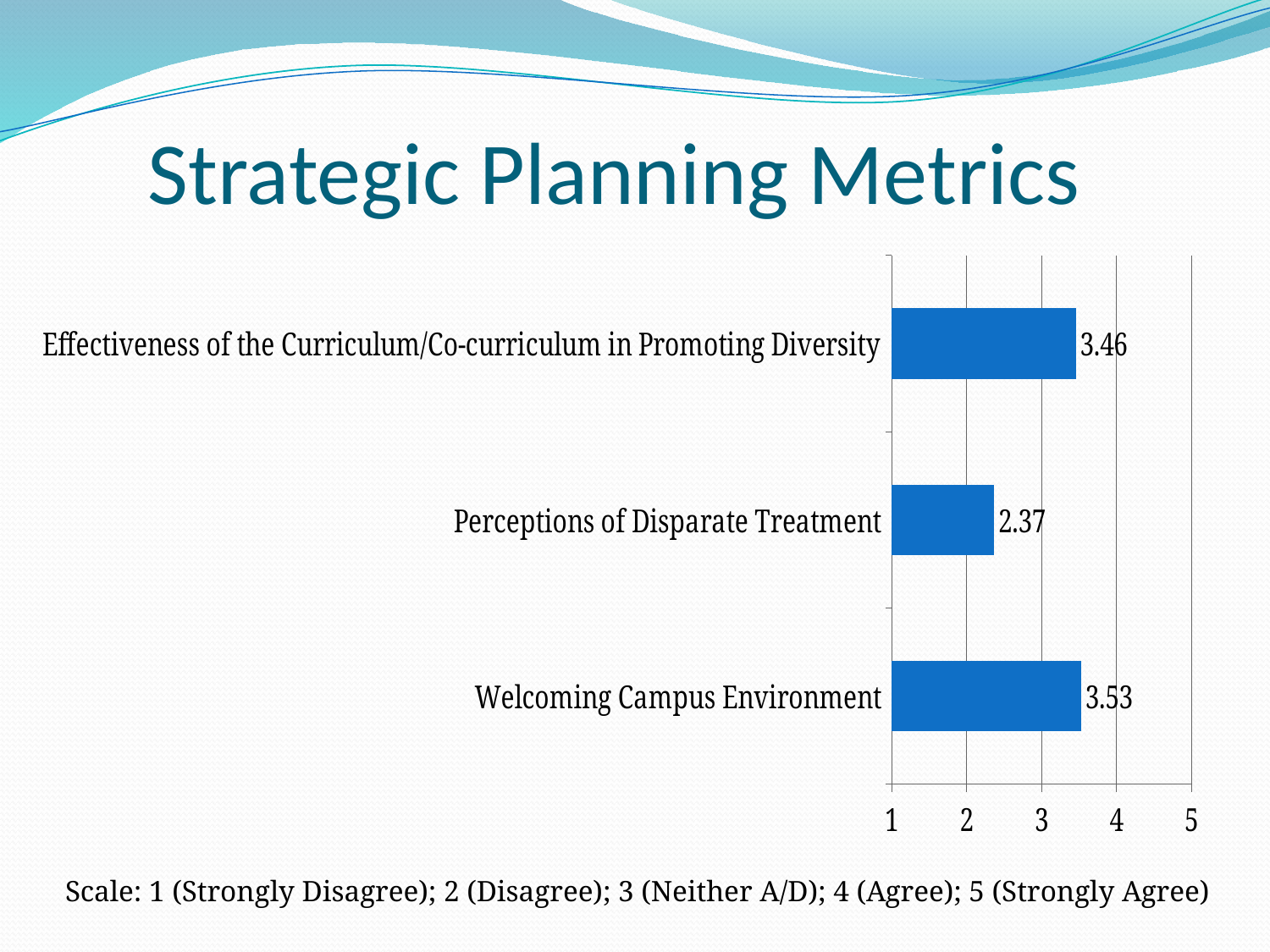
What is the title of the slide containing the chart? Strategic Planning Metrics What is the value for Welcoming Campus Environment? 3.53 Which category has the highest value? Welcoming Campus Environment Which category has the lowest value? Perceptions of Disparate Treatment Is the value for Perceptions of Disparate Treatment greater or less than 3? less What kind of chart is shown on the slide? bar chart What is the difference between the values for Effectiveness of the Curriculum/Co-curriculum in Promoting Diversity and Perceptions of Disparate Treatment? 1.09 Which is larger: the value for Welcoming Campus Environment or the value for Effectiveness of the Curriculum/Co-curriculum in Promoting Diversity? Welcoming Campus Environment What is the difference between the values for Welcoming Campus Environment and Perceptions of Disparate Treatment? 1.16 What is the value for Perceptions of Disparate Treatment? 2.37 How many categories are shown in the chart? 3 What is the value for Effectiveness of the Curriculum/Co-curriculum in Promoting Diversity? 3.46